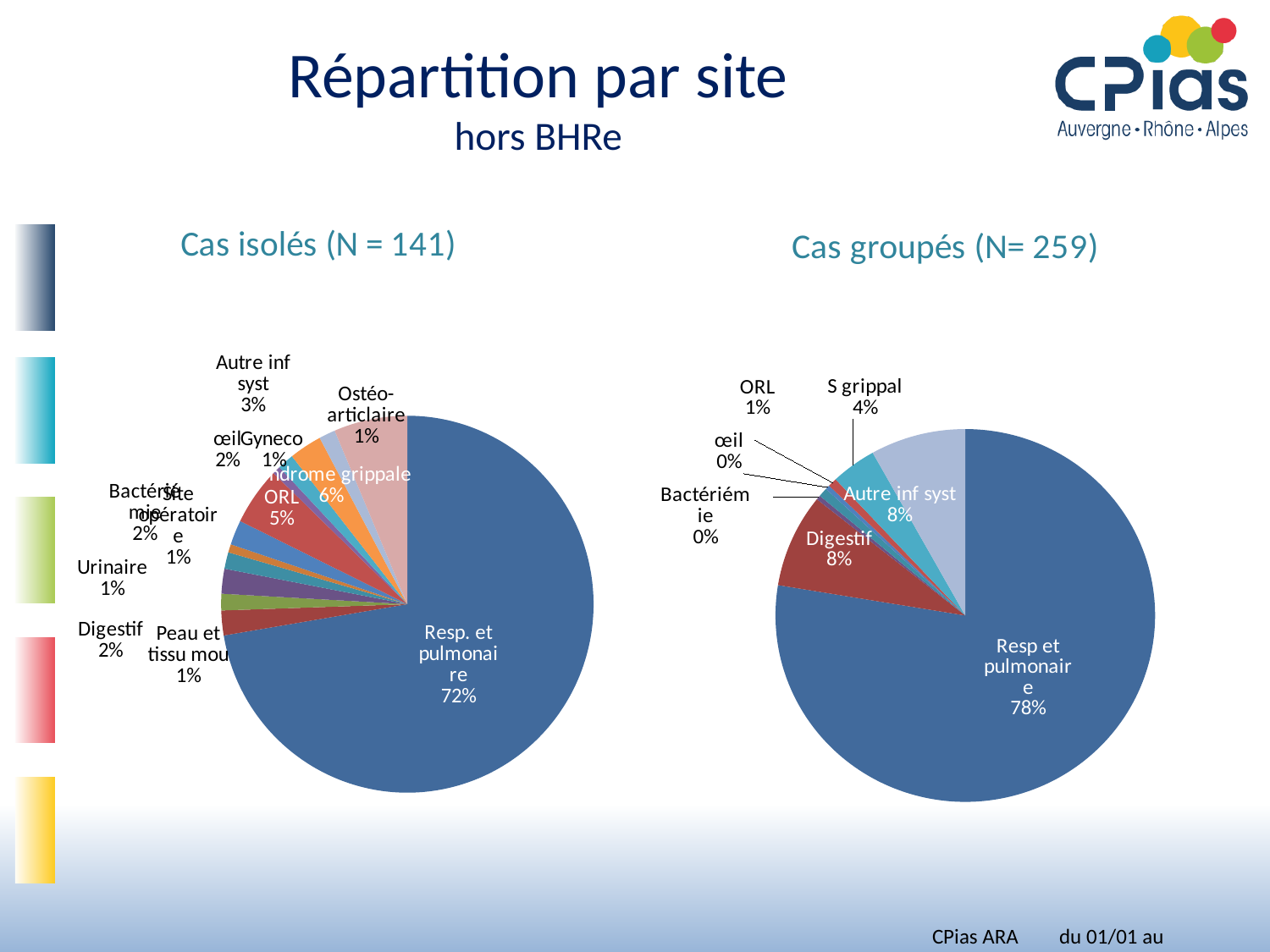
In the 'Cas groupés (N= 259)' chart, what share is 'Digestif'? 8% In the 'Cas isolés (N = 141)' chart, what share is 'ORL'? 5% In the 'Cas groupés (N= 259)' chart, what share is 'S grippal'? 4% In the 'Cas isolés (N = 141)' chart, what is the difference between the 'Resp. et pulmonaire' share and the 'Syndrome grippale' share? 66% In the 'Cas groupés (N= 259)' chart, what share is 'Resp et pulmonaire'? 78% In the 'Cas groupés (N= 259)' chart, which is larger: 'Digestif' or 'S grippal'? Digestif In the 'Cas isolés (N = 141)' chart, which category has the largest share? Resp. et pulmonaire In the 'Cas isolés (N = 141)' chart, what share is 'Autre inf syst'? 3% In the 'Cas isolés (N = 141)' chart, what share is 'Resp. et pulmonaire'? 72% What kind of charts are shown on the slide? Pie charts In the 'Cas groupés (N= 259)' chart, which category has the largest share? Resp et pulmonaire